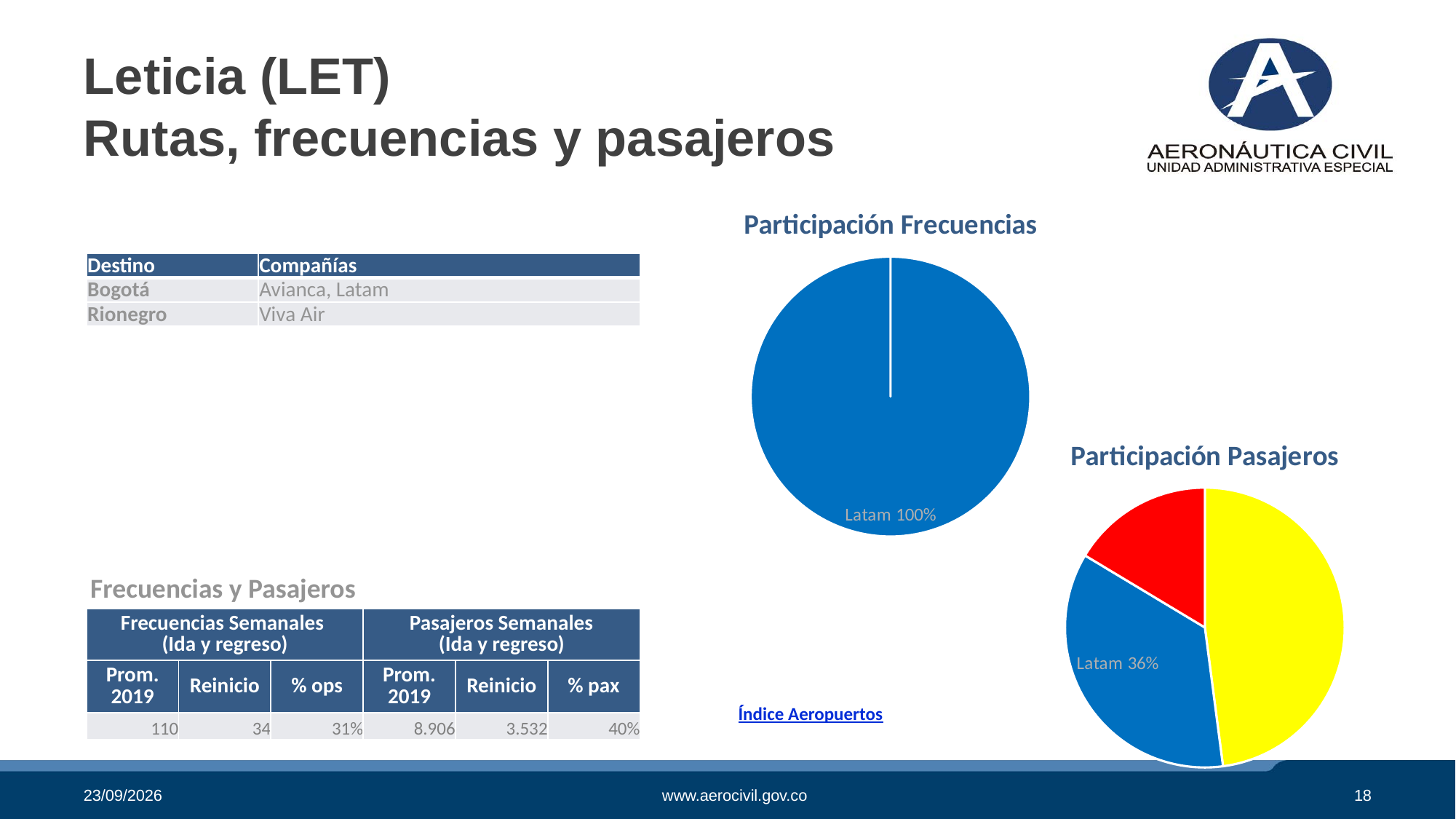
What is the title of the pie chart at the top right of the slide? Participación Frecuencias In the 'Participación Pasajeros' chart, is the Latam slice the largest slice? No In the 'Participación Pasajeros' chart, which slice is the smallest? The red slice How many slices does the 'Participación Pasajeros' pie chart have? 3 Which airline is the only one labelled in the 'Participación Frecuencias' chart? Latam What kind of chart is the 'Participación Pasajeros' chart? Pie chart In the 'Participación Pasajeros' chart, what share does Latam have? 36% In the 'Participación Frecuencias' chart, what share does Latam have? 100% In the 'Participación Pasajeros' chart, is the Latam share greater or less than 50%? less What colour is the Latam slice in the 'Participación Pasajeros' chart? Blue In the 'Participación Pasajeros' chart, which is larger: the Latam slice or the yellow slice? The yellow slice What kind of chart is the 'Participación Frecuencias' chart? Pie chart